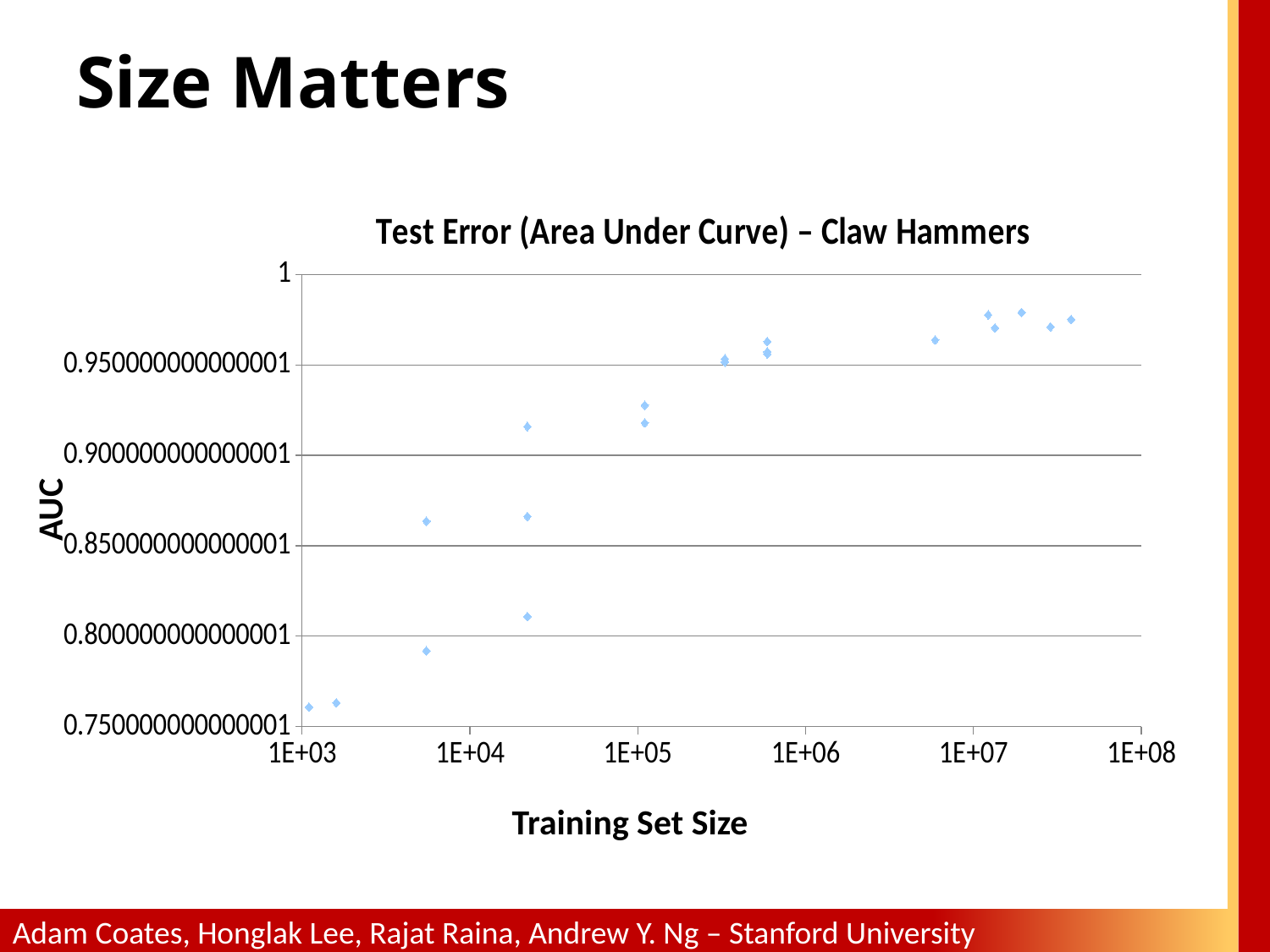
Are the AUC values for the points at training set size 1E+05 greater or less than 0.9? greater Is the lowest AUC value plotted on the chart greater or less than 0.8? less What is the title of the chart? Test Error (Area Under Curve) – Claw Hammers Is the AUC value for the point at training set size 1E+03 greater or less than 0.8? less What is the label of the x axis of the chart? Training Set Size Which has the higher AUC: the point at training set size 1E+03 or the points near 1E+07? the points near 1E+07 Which has the lower AUC: the points at training set size 1E+05 or the points near 1E+06? the points at 1E+05 What kind of chart is shown on the slide? scatter chart As the training set size increases along the x axis, do the AUC values generally rise or fall? rise